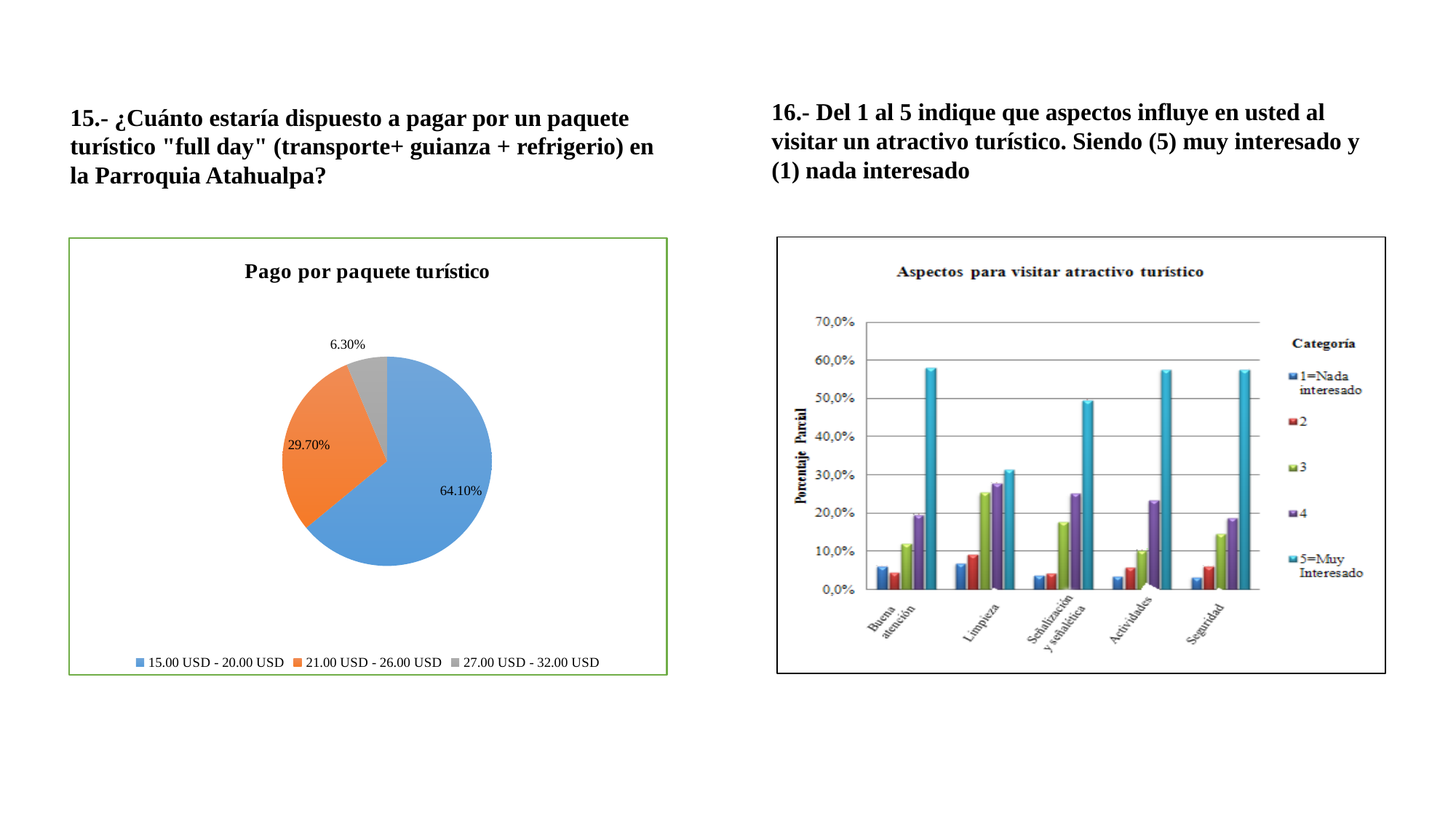
In the chart titled "Pago por paquete turístico", what share of respondents chose 27.00 USD - 32.00 USD? 6.30% What type of chart is the one titled "Aspectos para visitar atractivo turístico"? Bar chart In the chart titled "Pago por paquete turístico", what share of respondents chose 21.00 USD - 26.00 USD? 29.70% What type of chart is the one titled "Pago por paquete turístico"? Pie chart How many series does the legend of the chart titled "Aspectos para visitar atractivo turístico" list? 5 In the chart titled "Aspectos para visitar atractivo turístico", is the value of "5=Muy Interesado" for Limpieza greater or less than 40,0%? less In the chart titled "Pago por paquete turístico", which price range has the largest slice? 15.00 USD - 20.00 USD In the chart titled "Aspectos para visitar atractivo turístico", is the value of "5=Muy Interesado" for Buena atención greater or less than 50,0%? greater In the chart titled "Pago por paquete turístico", what share of respondents chose 15.00 USD - 20.00 USD? 64.10% In the chart titled "Pago por paquete turístico", which price range has the smallest slice? 27.00 USD - 32.00 USD In the chart titled "Pago por paquete turístico", what is the difference in percentage points between the 15.00 USD - 20.00 USD slice and the 21.00 USD - 26.00 USD slice? 34.40 percentage points How many categories are shown on the x axis of the chart titled "Aspectos para visitar atractivo turístico"? 5